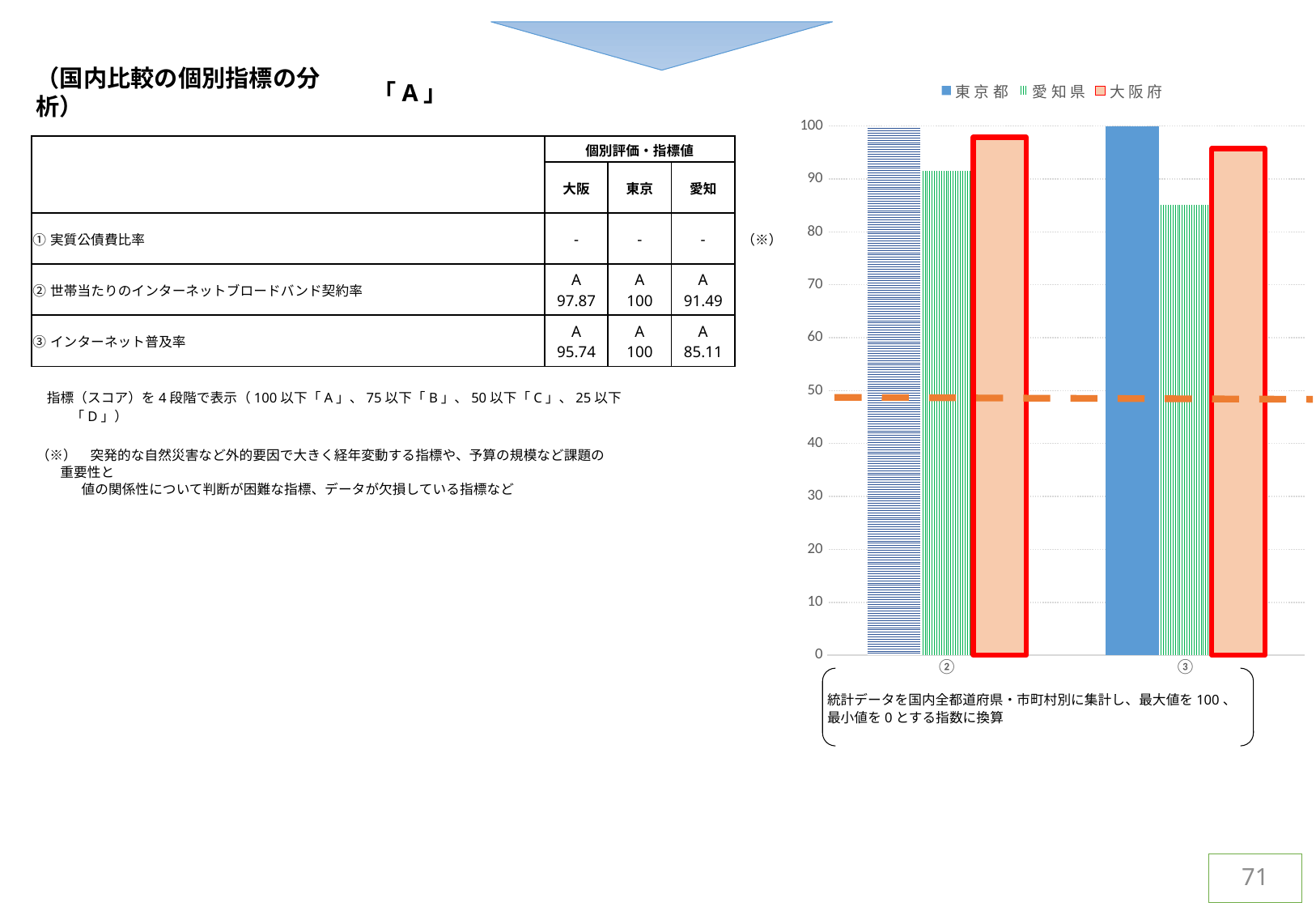
In the bar chart, is the value for 愛知県 in category ③ greater or less than 90? less In the bar chart, which series has the lowest value in category ③? 愛知県 In the bar chart, which series has the highest value in category ③? 東京都 In the bar chart, which series' bars are outlined in red? 大阪府 In the bar chart, is the value for 愛知県 in category ② greater or less than 80? greater How many series does the legend of the bar chart list? 3 In the bar chart, which is larger in category ②: the value for 大阪府 or the value for 愛知県? 大阪府 How many categories are shown on the x axis of the bar chart? 2 In the bar chart, what is the value for 東京都 in category ②? 100 In the bar chart, what is the value for 東京都 in category ③? 100 What kind of chart is shown on the right side of the slide? bar chart In the bar chart, is the value for 大阪府 in category ③ greater or less than 90? greater